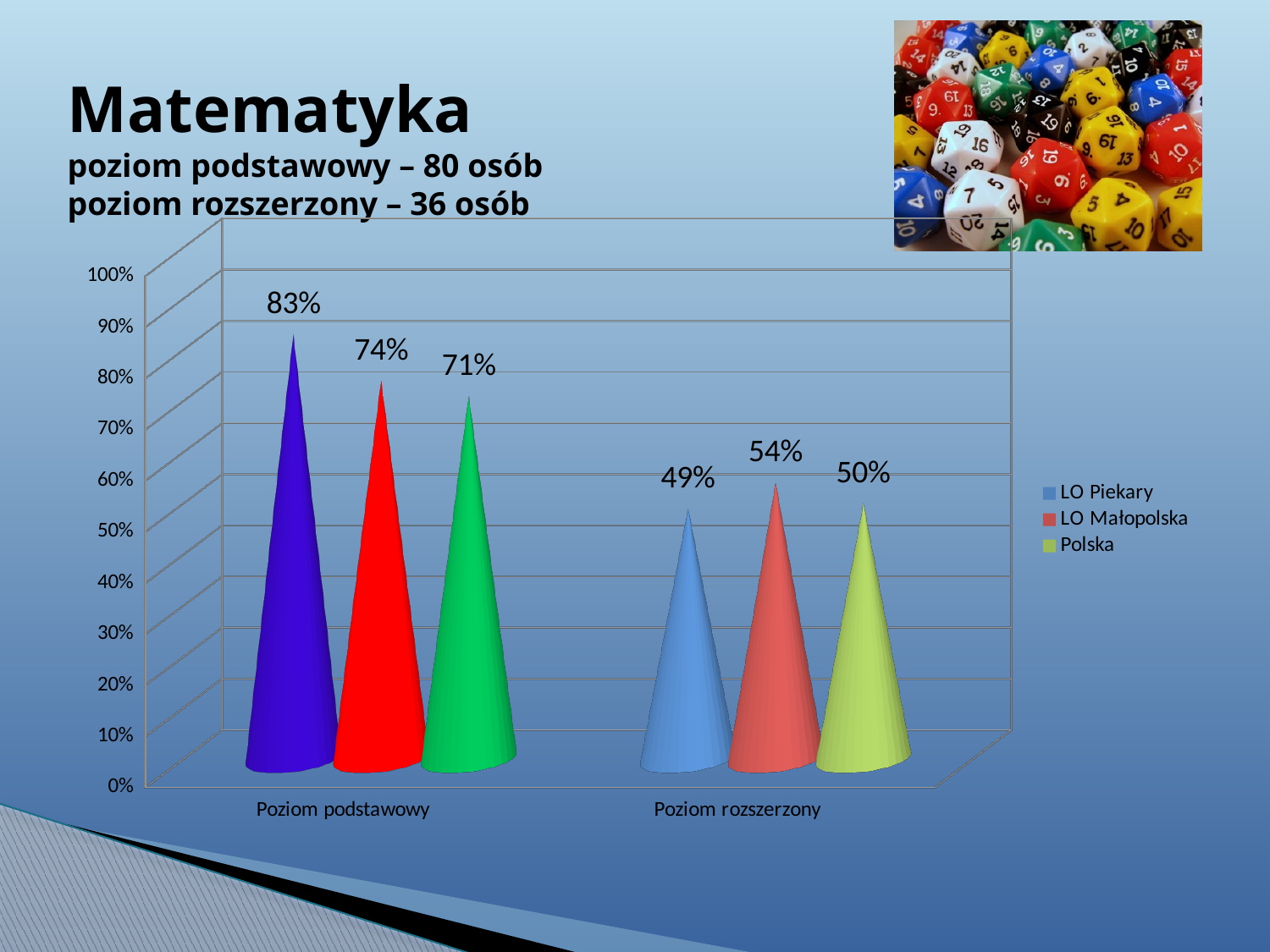
What is the value for Polska at Poziom podstawowy? 71% How many categories are shown on the x axis? 2 How many series does the legend list? 3 What is the difference between LO Małopolska and LO Piekary at Poziom rozszerzony? 5% What is the value for LO Piekary at Poziom rozszerzony? 49% What is the value for LO Małopolska at Poziom rozszerzony? 54% What is the difference between LO Piekary and Polska at Poziom podstawowy? 12% Which is larger: LO Małopolska at Poziom podstawowy or LO Małopolska at Poziom rozszerzony? Poziom podstawowy Which series has the highest value at Poziom podstawowy? LO Piekary Which series has the lowest value at Poziom rozszerzony? LO Piekary What kind of chart is shown on the slide? Bar chart What is the value for LO Piekary at Poziom podstawowy? 83%